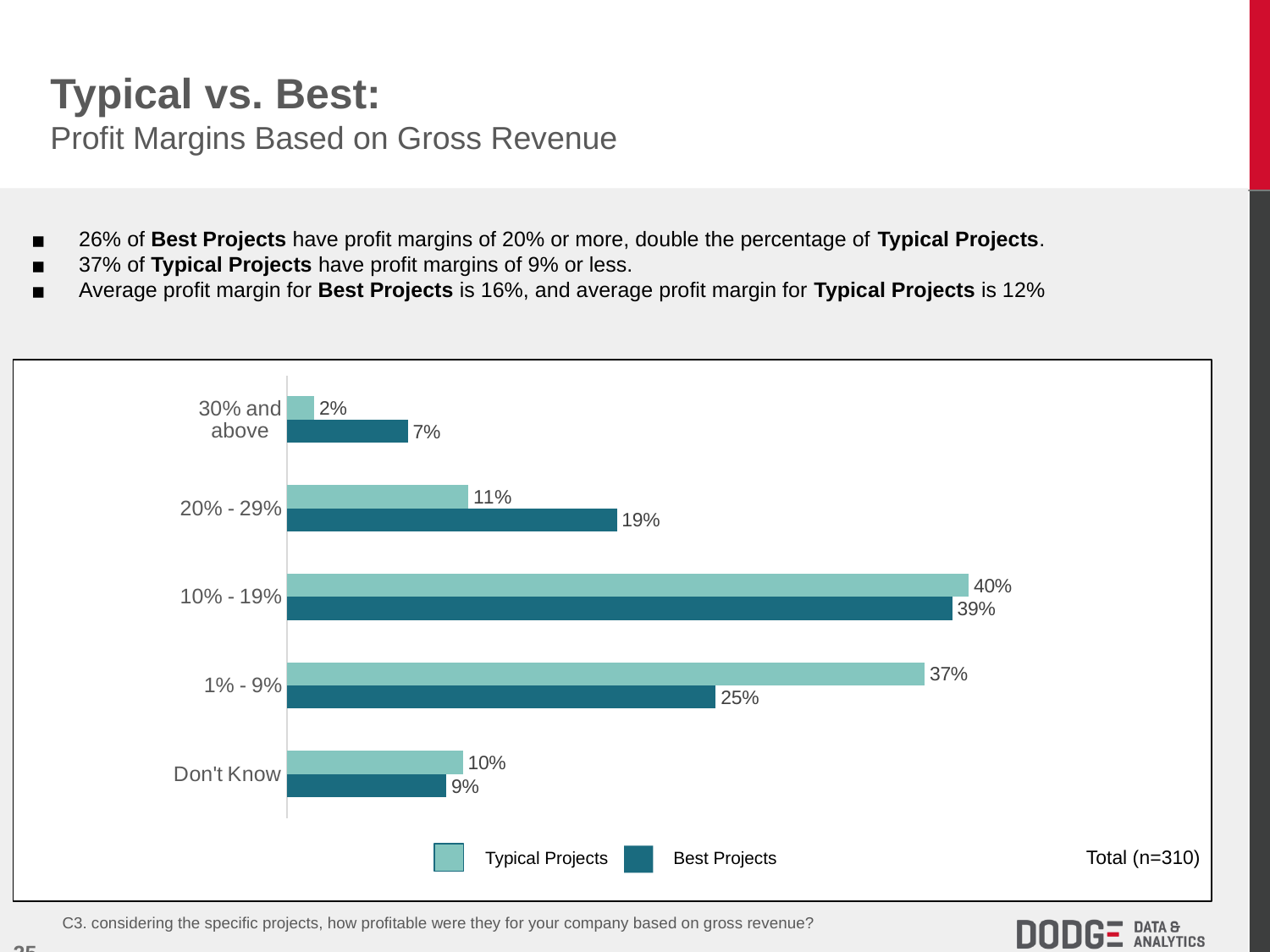
What percentage of Typical Projects have profit margins of 10% - 19%? 40% What is the value for Best Projects in the 1% - 9% category? 25% In the 20% - 29% category, which series has the larger value, Typical Projects or Best Projects? Best Projects What percentage of Best Projects have profit margins of 30% and above? 7% Which category has the lowest value for Typical Projects? 30% and above What kind of chart is shown on the slide? Bar chart Which category has the highest value for Best Projects? 10% - 19% What is the difference between Typical Projects and Best Projects in the 1% - 9% category? 12% How many series does the legend list? 2 What sample size is noted on the chart? Total (n=310) What is the difference between Best Projects and Typical Projects in the 20% - 29% category? 8% How many profit margin categories are shown on the chart? 5